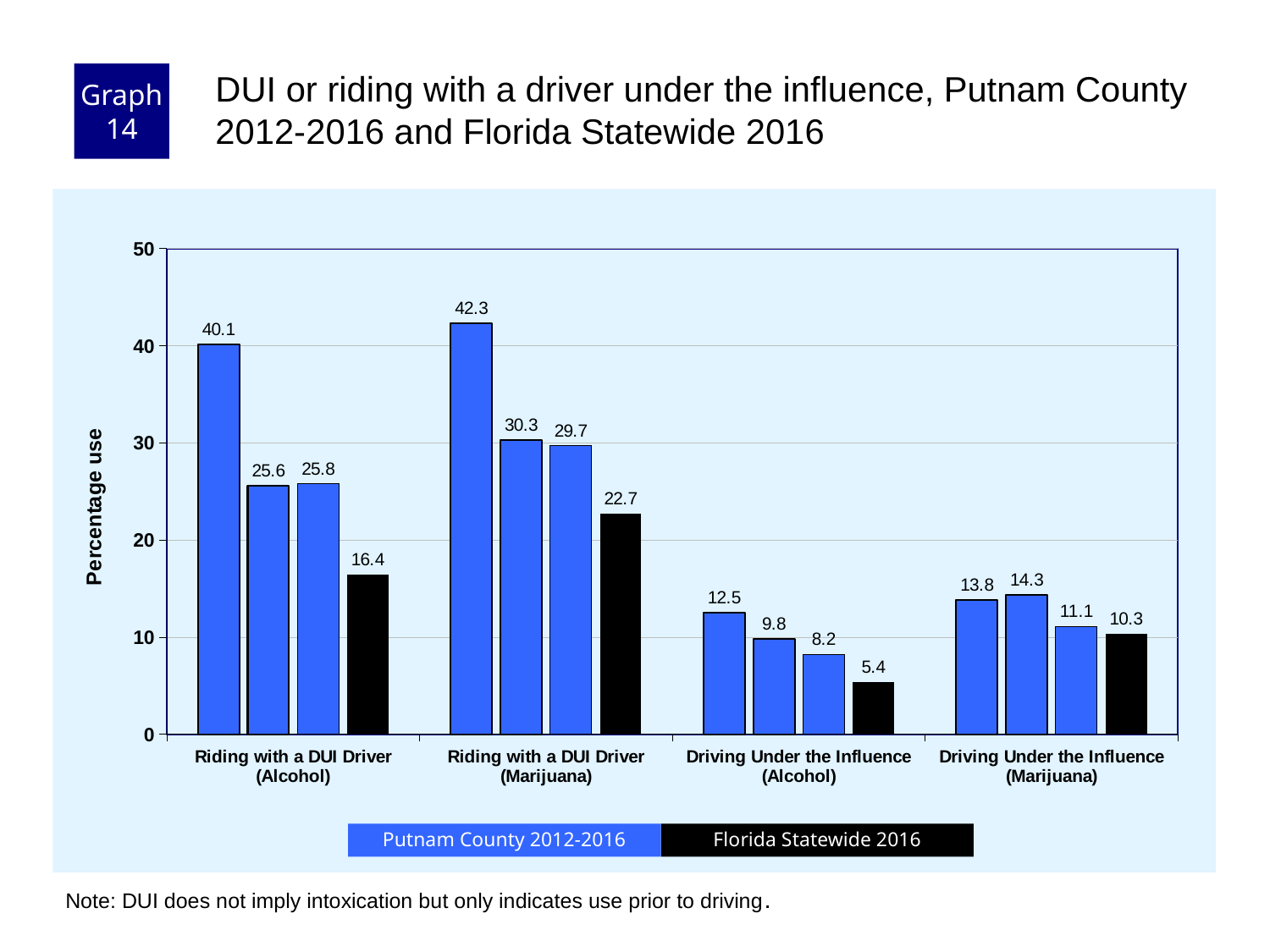
How many categories are shown on the x axis? 4 What kind of chart is shown? Bar chart How many series does the legend list? 2 What is the difference between the Florida Statewide 2016 values for Riding with a DUI Driver (Marijuana) and Riding with a DUI Driver (Alcohol)? 6.3 What is the lowest value shown on the chart? 5.4 What is the Florida Statewide 2016 value for Driving Under the Influence (Marijuana)? 10.3 What is the Florida Statewide 2016 value for Riding with a DUI Driver (Alcohol)? 16.4 Which is larger: the Florida Statewide 2016 value for Driving Under the Influence (Marijuana) or for Driving Under the Influence (Alcohol)? Driving Under the Influence (Marijuana) What is the Florida Statewide 2016 value for Driving Under the Influence (Alcohol)? 5.4 What is the Florida Statewide 2016 value for Riding with a DUI Driver (Marijuana)? 22.7 What is the highest value shown on the chart? 42.3 What is the label of the y axis? Percentage use